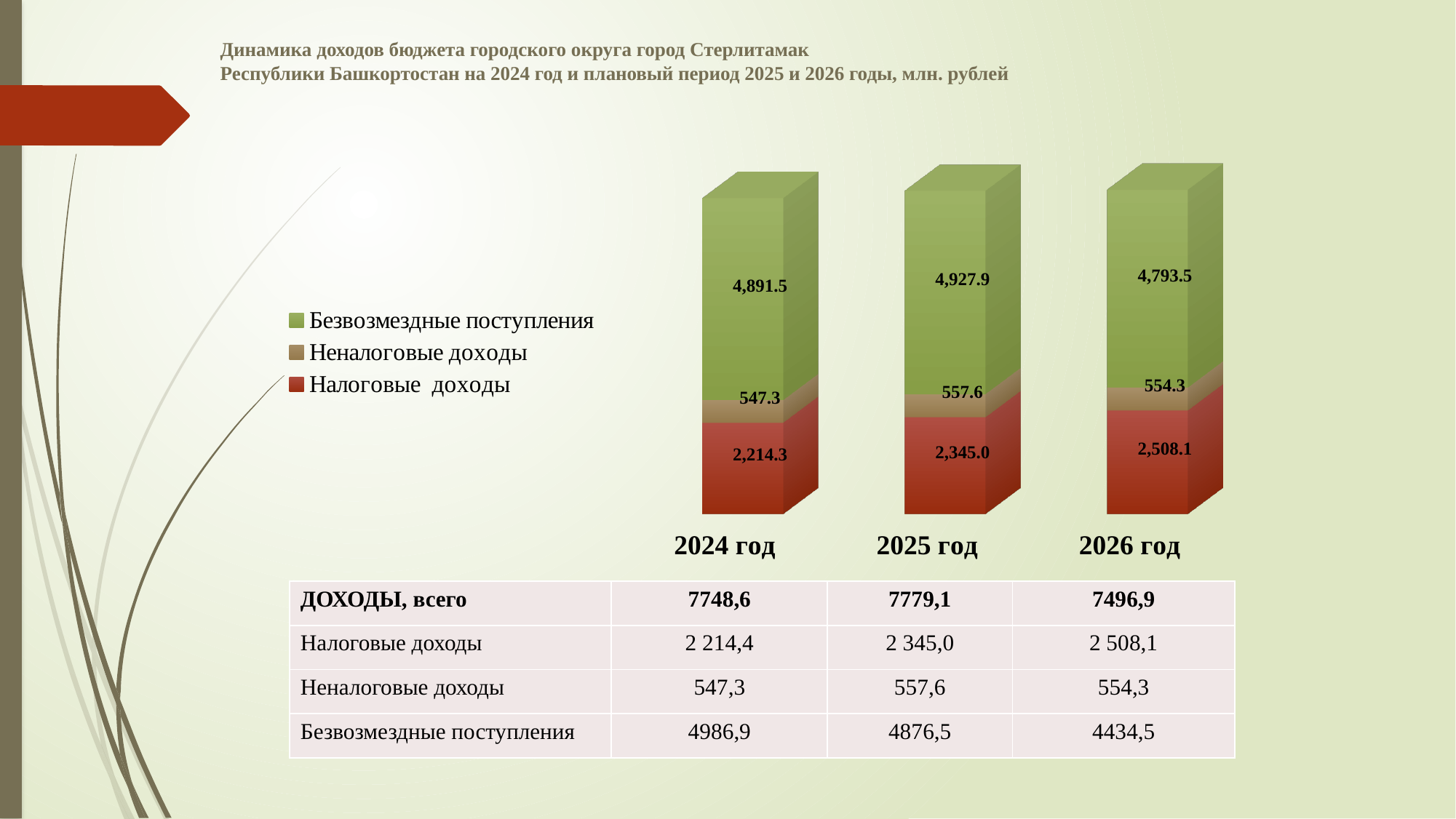
In which year is the Налоговые доходы segment the highest in the chart? 2026 год Does the Налоговые доходы segment rise or fall from 2024 год to 2026 год in the chart? Rise By how much does Налоговые доходы in 2026 год exceed Налоговые доходы in 2024 год in the chart? 293.8 What is the value of Налоговые доходы for 2024 год in the chart? 2,214.3 Which is larger in the chart: Безвозмездные поступления in 2024 год or in 2026 год? 2024 год In which year is the Неналоговые доходы segment the lowest in the chart? 2024 год What type of chart is shown on the slide? Stacked bar chart What is the value of Безвозмездные поступления for 2025 год in the chart? 4,927.9 How many years (categories) are shown on the x axis of the chart? 3 What is the value of Неналоговые доходы for 2026 год in the chart? 554.3 How many series does the chart legend list? 3 What is the difference between Неналоговые доходы in 2025 год and 2024 год in the chart? 10.3